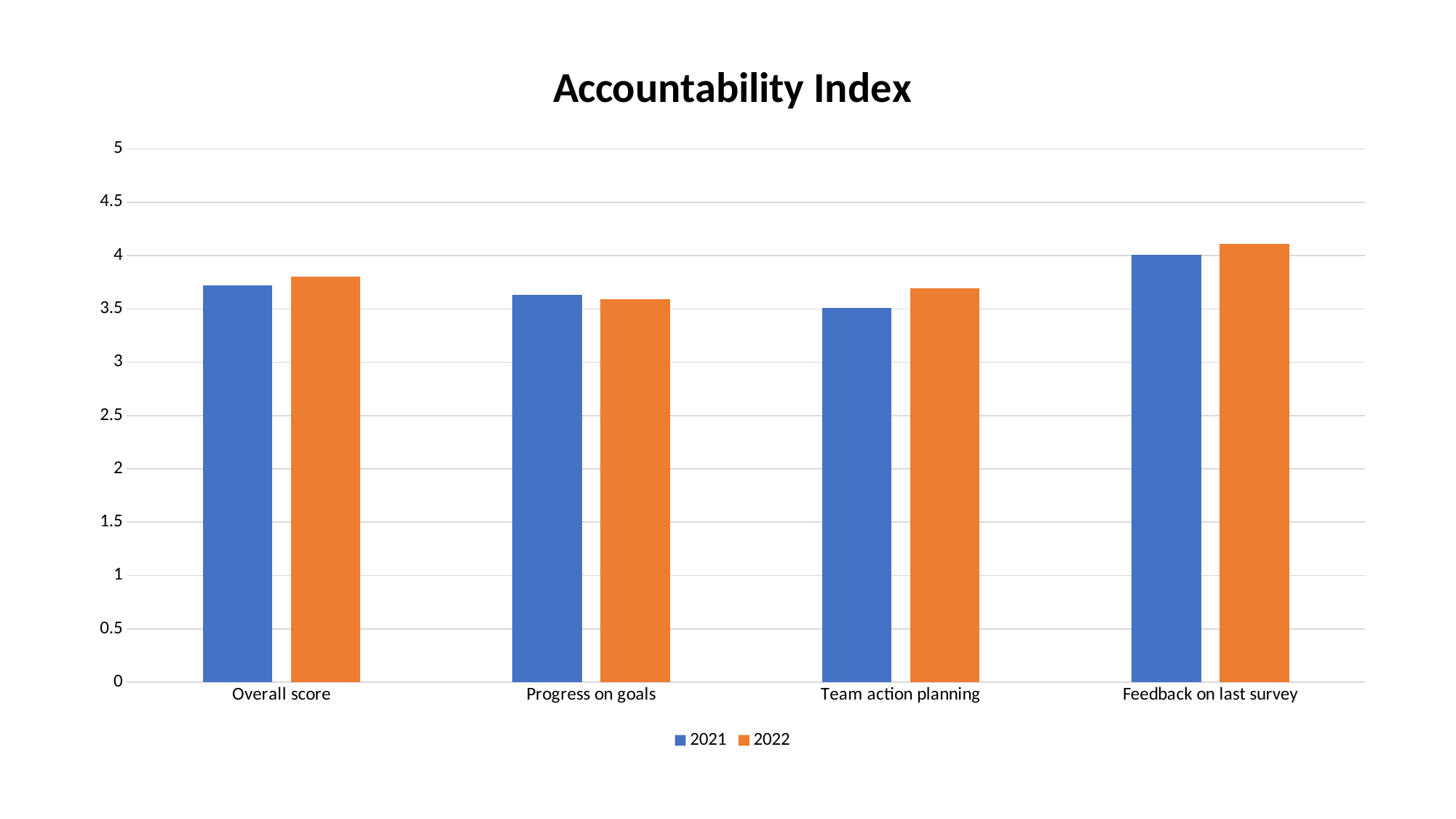
What kind of chart is shown on the slide? bar chart Is the value for Feedback on last survey in 2022 greater or less than 4? greater Is the value for Overall score in 2021 greater or less than 3.5? greater Which colour represents the 2022 series? orange Which category has the lowest value for 2021? Team action planning Which category has the lowest value for 2022? Progress on goals For Team action planning, which year has the larger value, 2021 or 2022? 2022 How many categories are shown on the x axis? 4 How many series does the legend list? 2 Which category has the highest value for 2022? Feedback on last survey Is the value for Team action planning in 2022 greater or less than 4? less What is the title of the chart? Accountability Index